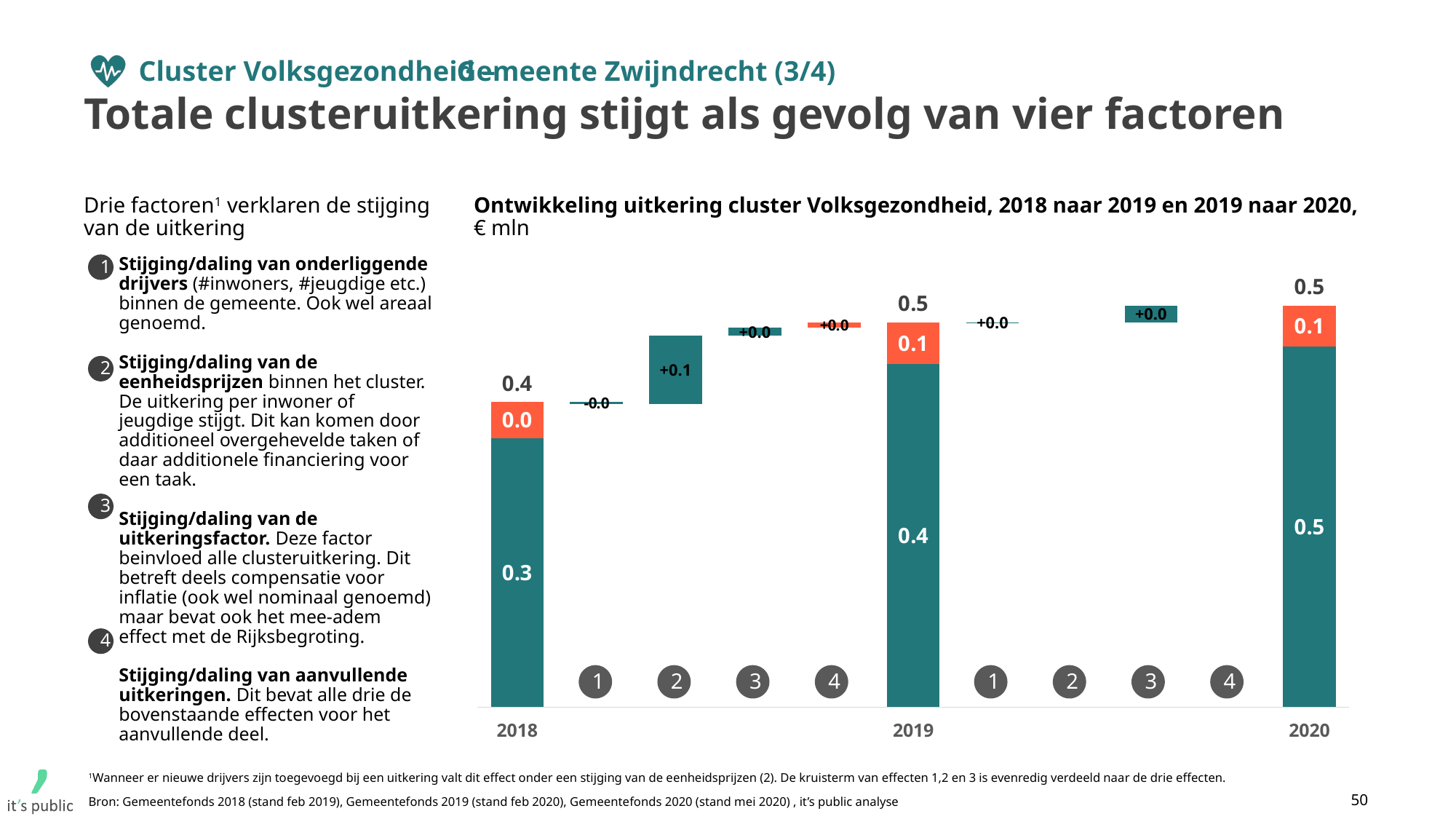
What is the total value shown above the 2018 bar? 0.4 What value is printed in the orange (upper) segment of the 2019 bar? 0.1 What kind of chart is shown on the slide? bar chart What is the difference between the total for 2019 and the total for 2018? 0.1 Which is larger, the total for 2018 or the total for 2019? 2019 What value is printed in the teal (lower) segment of the 2020 bar? 0.5 What value is printed in the teal (lower) segment of the 2018 bar? 0.3 What is the total value shown above the 2019 bar? 0.5 Which year has the lowest total value? 2018 How many year totals (2018, 2019, 2020) are shown as full bars in the chart? 3 What is the total value shown above the 2020 bar? 0.5 What is the value of step 2 between 2018 and 2019? +0.1